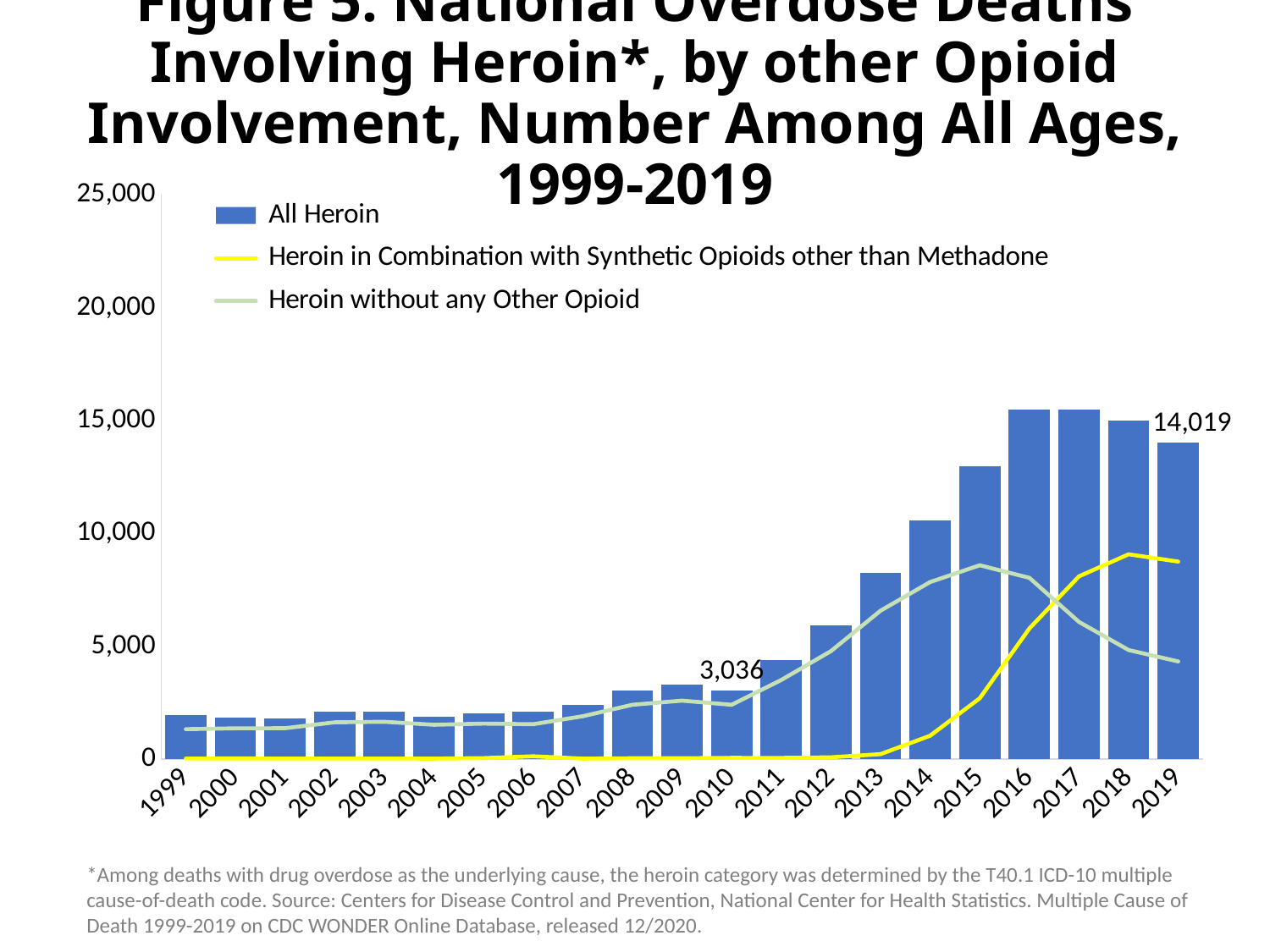
Is the All Heroin value for 2015 greater or less than 10,000? greater What is the value of the All Heroin bar for 2010? 3,036 What is the difference between the All Heroin values for 2019 and 2010? 10,983 What is the value of the All Heroin bar for 2019? 14,019 Is the All Heroin value for 2011 greater or less than 5,000? less Which year has the larger All Heroin value, 2010 or 2019? 2019 How many years are shown on the x axis? 21 How many series does the legend list? 3 Is the All Heroin value for 2013 greater or less than 10,000? less Do the All Heroin values rise or fall from 2017 to 2019? fall In 2019, which is higher: Heroin in Combination with Synthetic Opioids other than Methadone or Heroin without any Other Opioid? Heroin in Combination with Synthetic Opioids other than Methadone What colour is used for the All Heroin series? Blue